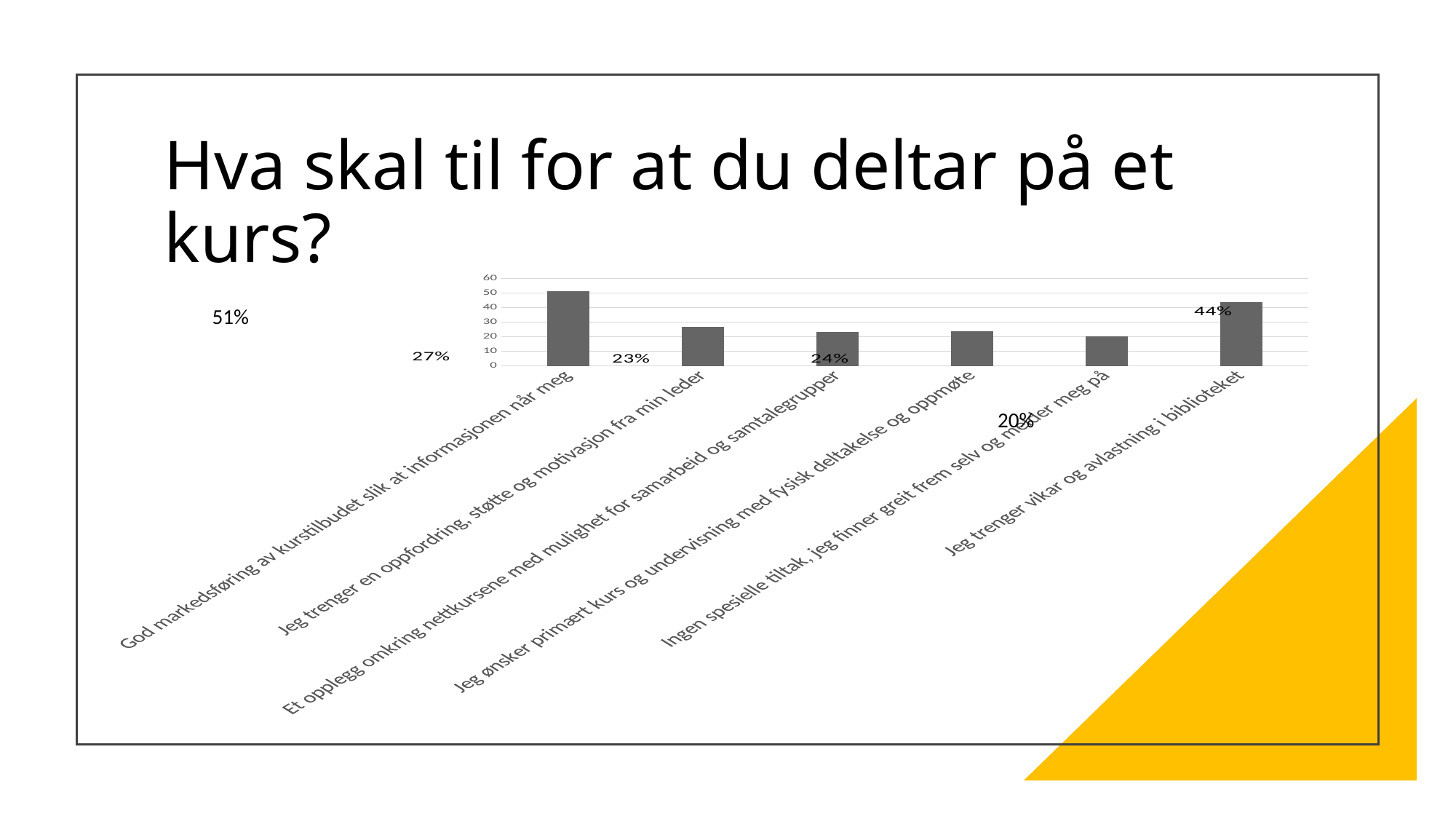
What kind of chart is shown on the slide? bar chart Is the value for 'Jeg trenger vikar og avlastning i biblioteket' greater or less than 40? greater How many categories (bars) does the chart show? 6 Which category has the highest value in the chart? God markedsføring av kurstilbudet slik at informasjonen når meg What is the difference between the values for 'God markedsføring av kurstilbudet slik at informasjonen når meg' (51%) and 'Jeg trenger vikar og avlastning i biblioteket' (44%)? 7 percentage points What is the value for 'God markedsføring av kurstilbudet slik at informasjonen når meg'? 51% Which category has the lowest value in the chart? Ingen spesielle tiltak, jeg finner greit frem selv og melder meg på What is the highest value shown on the vertical axis of the chart? 60 What is the value for 'Jeg trenger en oppfordring, støtte og motivasjon fra min leder'? 27% What is the value for 'Jeg trenger vikar og avlastning i biblioteket'? 44% What is the title of the slide containing the chart? Hva skal til for at du deltar på et kurs? Which is larger: the value for 'God markedsføring av kurstilbudet slik at informasjonen når meg' or for 'Jeg trenger vikar og avlastning i biblioteket'? God markedsføring av kurstilbudet slik at informasjonen når meg